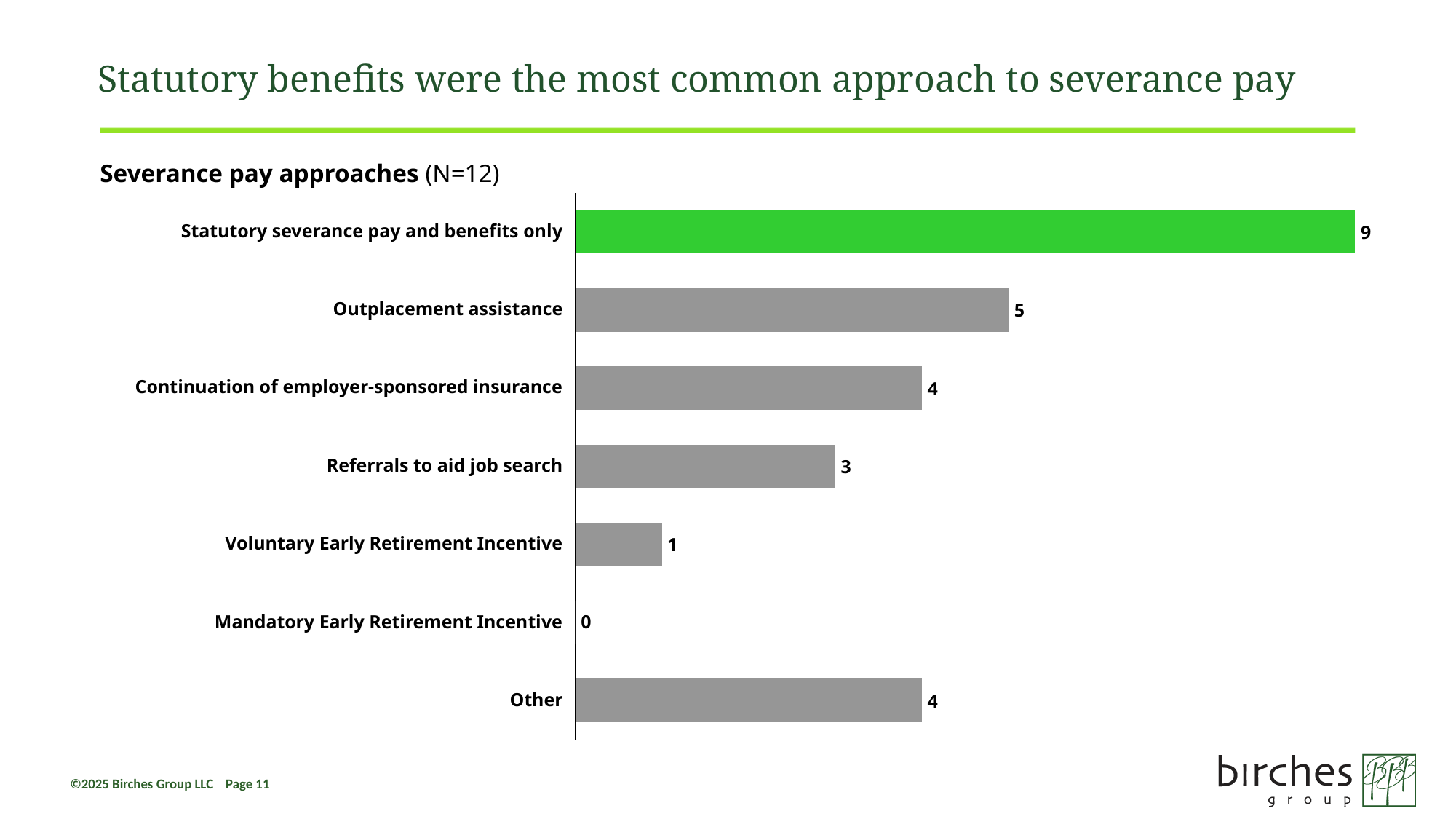
How many categories are shown in the chart? 7 What is the title of the chart? Severance pay approaches (N=12) Which category has the lowest value? Mandatory Early Retirement Incentive What is the value for Statutory severance pay and benefits only? 9 Which bar is coloured green rather than grey? Statutory severance pay and benefits only What is the difference between the values for Statutory severance pay and benefits only and Outplacement assistance? 4 Which is larger, the value for Continuation of employer-sponsored insurance or the value for Referrals to aid job search? Continuation of employer-sponsored insurance What kind of chart is shown on the slide? Bar chart What is the value for Mandatory Early Retirement Incentive? 0 What is the value for Outplacement assistance? 5 What is the value for Referrals to aid job search? 3 Which category has the highest value? Statutory severance pay and benefits only